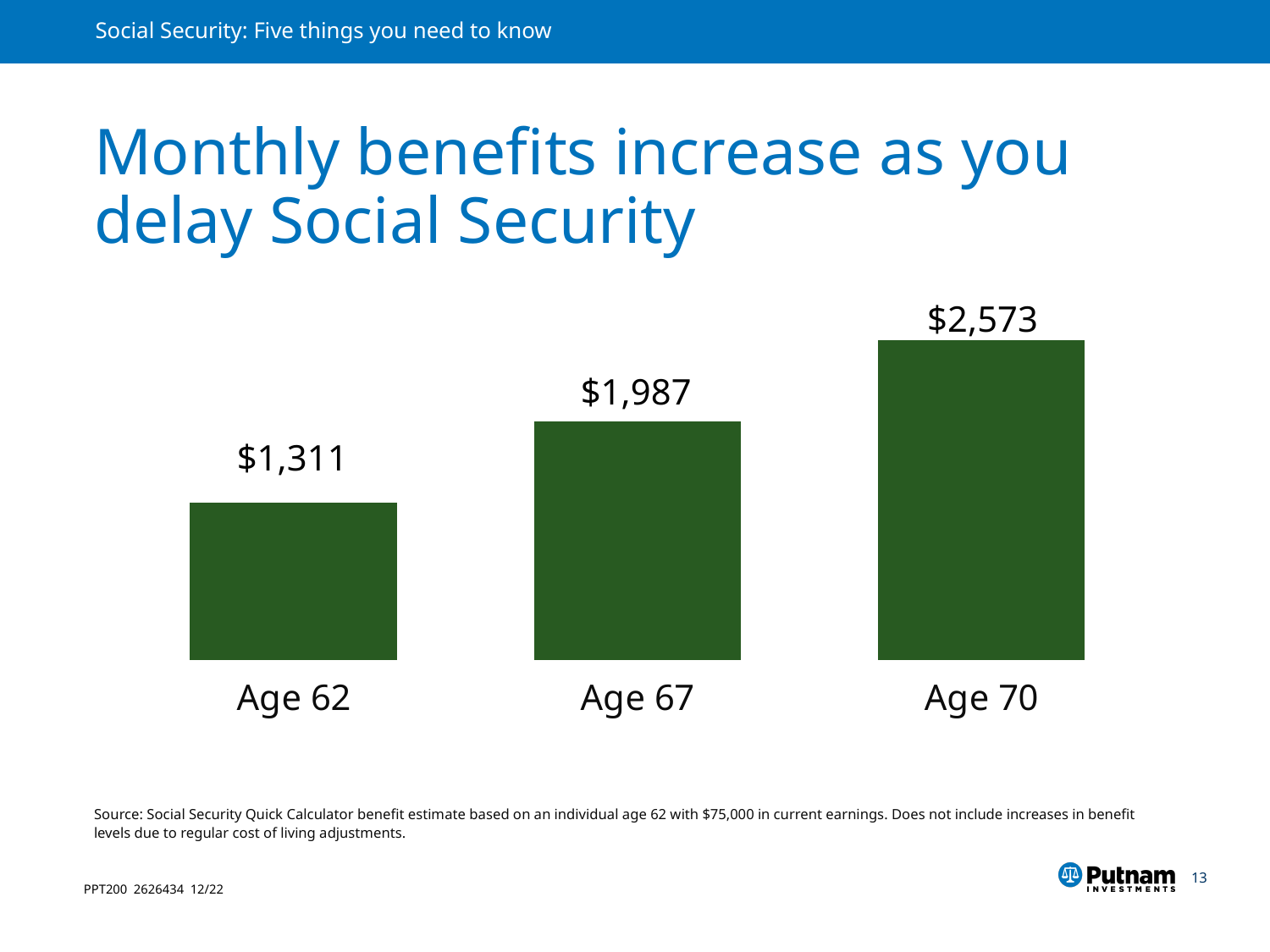
Which age has the highest monthly benefit? Age 70 What is the monthly benefit shown for Age 62? $1,311 What is the monthly benefit shown for Age 70? $2,573 What is the monthly benefit shown for Age 67? $1,987 What is the difference between the monthly benefit at Age 67 and at Age 62? $676 What kind of chart is shown on the slide? Bar chart How many age categories are shown in the chart? 3 What is the difference between the monthly benefit at Age 70 and at Age 62? $1,262 Which age has the lowest monthly benefit? Age 62 Do the monthly benefits rise or fall as age increases from left to right? Rise Which is larger, the monthly benefit at Age 67 or at Age 70? Age 70 What colour are the bars in the chart? Dark green